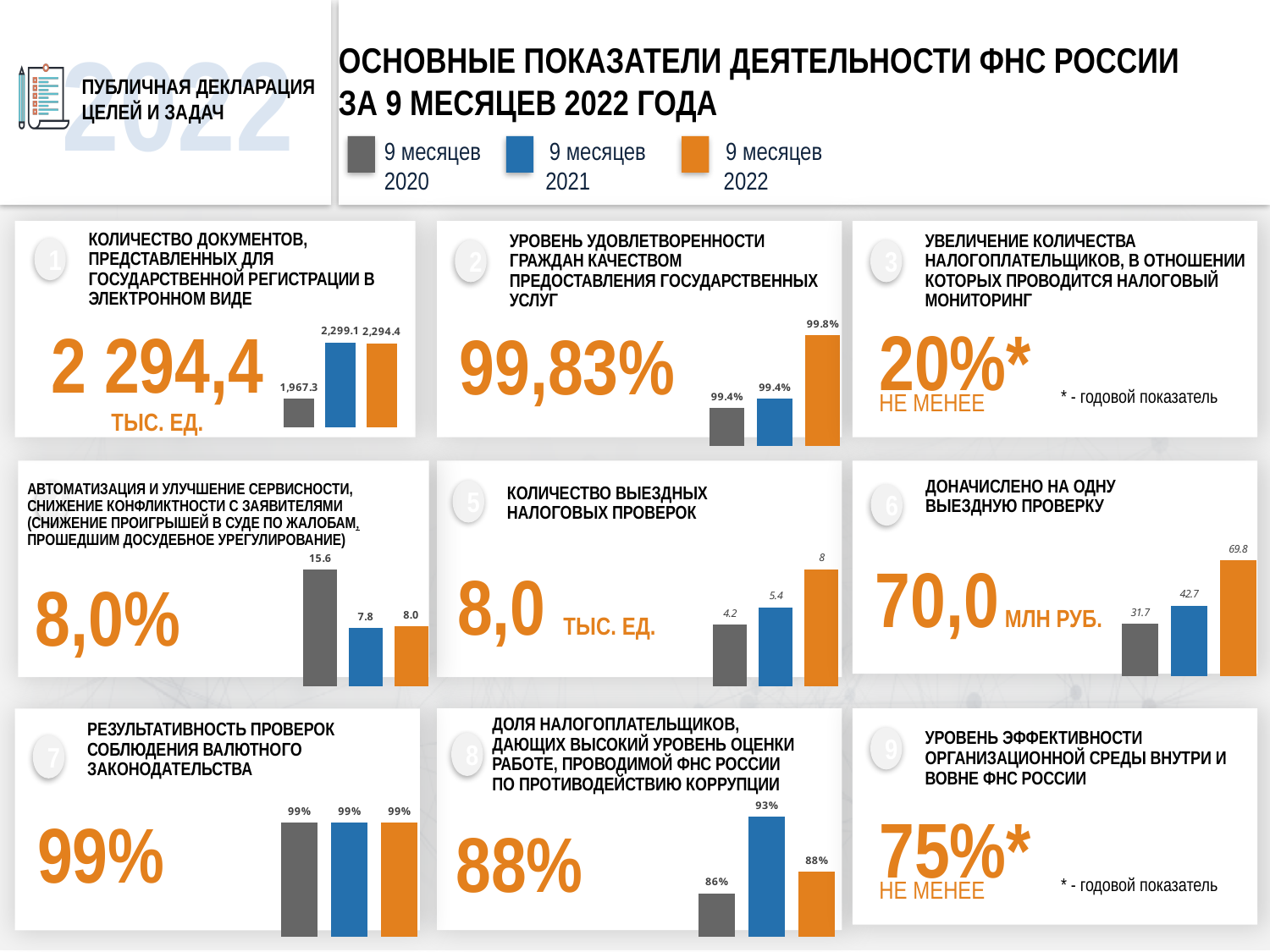
In the chart for indicator 1 (Количество документов, представленных для государственной регистрации в электронном виде), what is the value for 9 месяцев 2021? 2,299.1 In the chart for indicator 6 (Доначислено на одну выездную проверку), what is the value for 9 месяцев 2020? 31.7 How many periods does the legend at the top of the slide list? 3 In the chart for indicator 4 (Автоматизация и улучшение сервисности), which period has the highest value? 9 месяцев 2020 According to the legend, which colour represents 9 месяцев 2022? orange In the chart for indicator 8 (Доля налогоплательщиков, дающих высокий уровень оценки работе по противодействию коррупции), which period has the lowest value? 9 месяцев 2020 In the chart for indicator 6 (Доначислено на одну выездную проверку), what is the difference between the 2022 and 2021 values? 27.1 In the chart for indicator 8 (Доля налогоплательщиков, дающих высокий уровень оценки), what is the difference between the 2021 and 2022 values? 5% In the chart for indicator 1 (Количество документов в электронном виде), which is larger: the value for 2021 or for 2022? 2021 In the chart for indicator 5 (Количество выездных налоговых проверок), do the values rise or fall from 2020 to 2022? rise What type of chart is used for indicator 2 (Уровень удовлетворенности граждан качеством предоставления государственных услуг)? bar chart In the chart for indicator 5 (Количество выездных налоговых проверок), what is the value for 9 месяцев 2022? 8